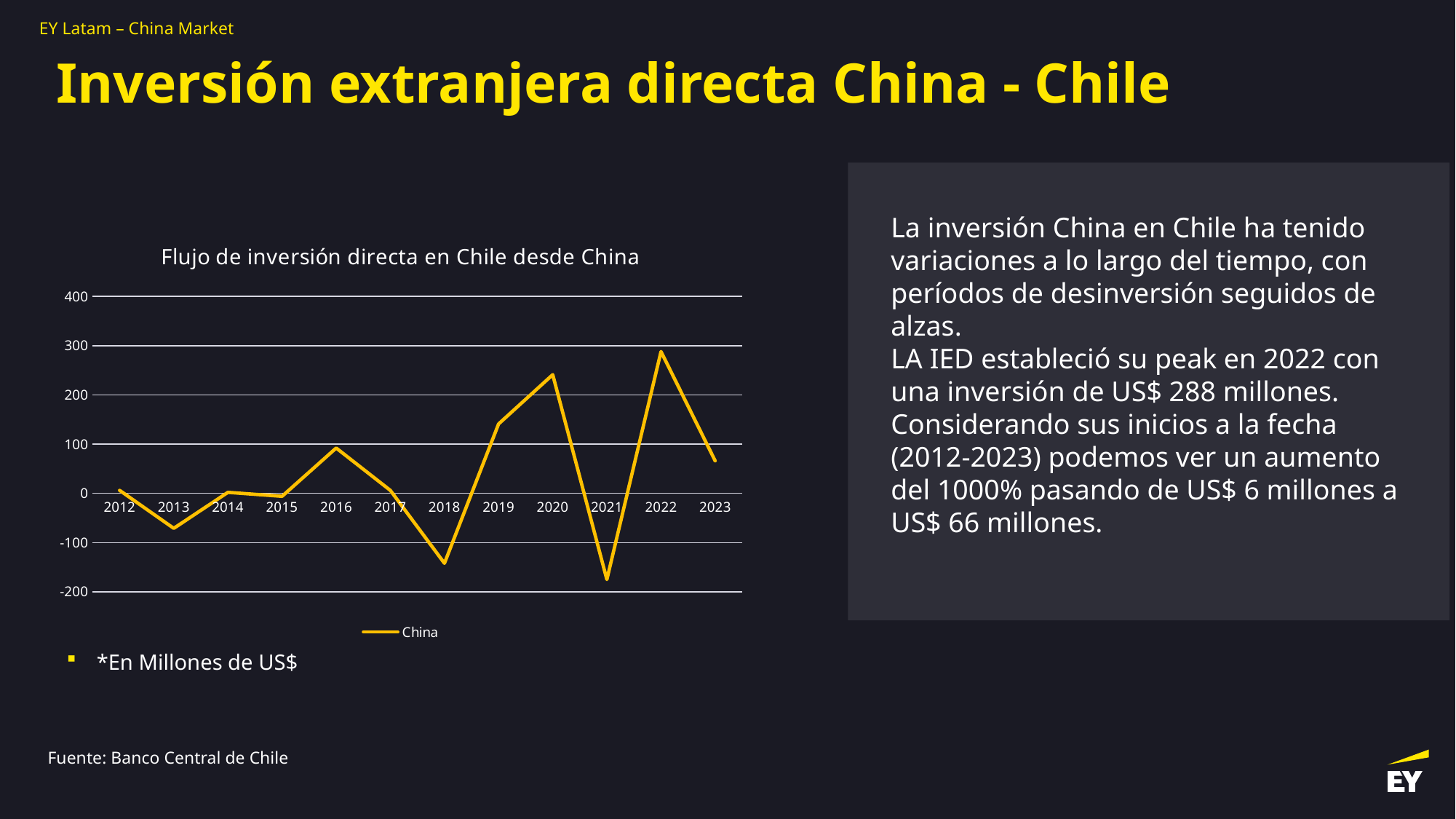
Is the value for 2018 greater or less than -100? less Is the value for 2021 greater or less than -100? less What is the name of the series shown in the chart legend? China How many years are plotted on the x axis of the chart? 12 Does the line rise or fall from 2022 to 2023? fall Is the value for 2020 greater or less than 200? greater What is the title of the chart? Flujo de inversión directa en Chile desde China Which year has the larger value, 2019 or 2020? 2020 How many series does the chart legend list? 1 In which year does the line reach its lowest value? 2021 In which year does the line reach its highest value? 2022 What kind of chart is shown on the slide? line chart